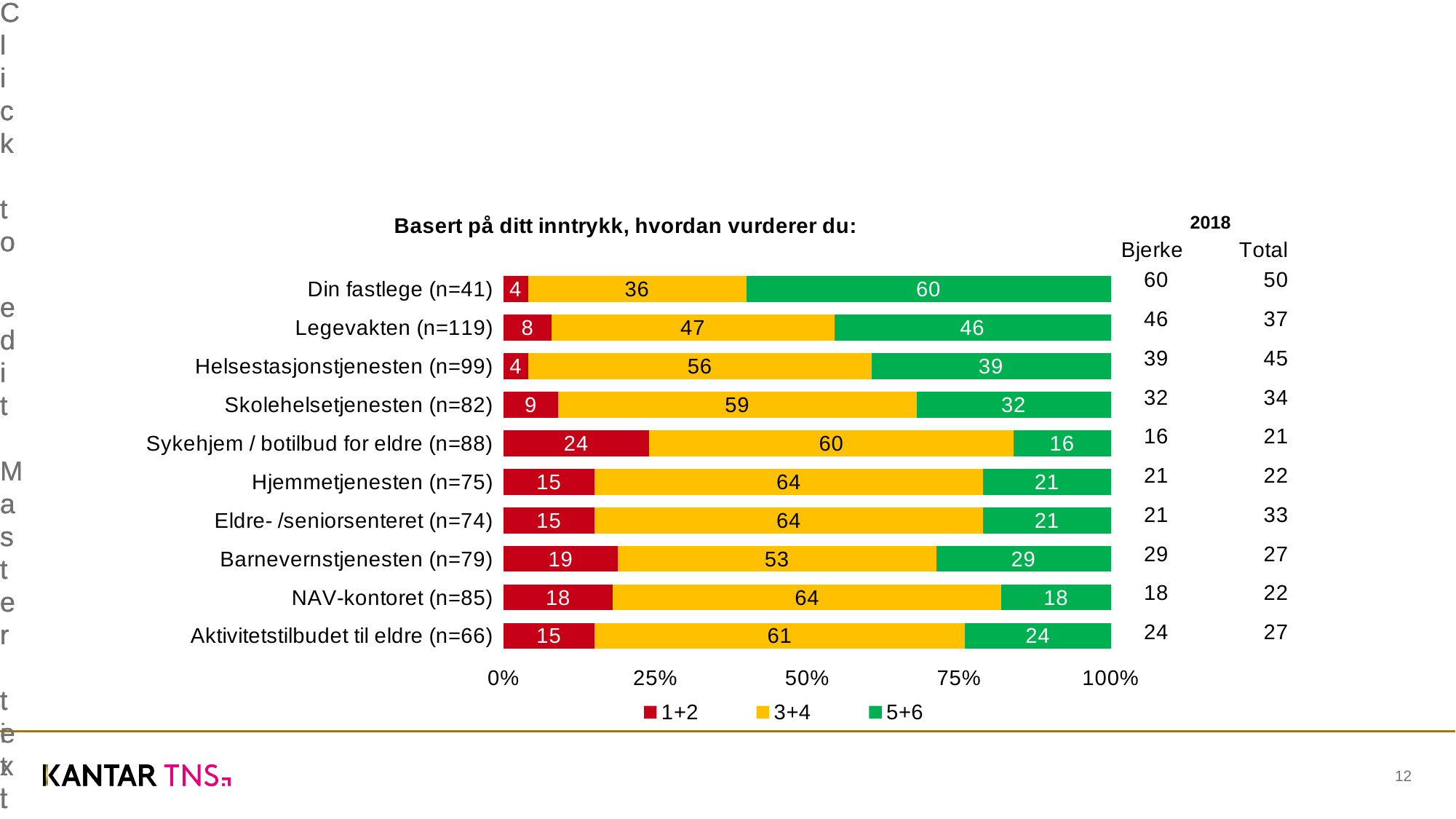
What is the total of the stacked bar for NAV-kontoret (n=85)? 100 Which category has the lowest 5+6 value? Sykehjem / botilbud for eldre (n=88) How many categories are shown in the chart? 10 What is the value of the 3+4 segment for Skolehelsetjenesten (n=82)? 59 What kind of chart is shown on the slide? Stacked bar chart What is the difference between the 5+6 value for Din fastlege (n=41) and the 5+6 value for Sykehjem / botilbud for eldre (n=88)? 44 Which has a larger 5+6 value, Legevakten (n=119) or Helsestasjonstjenesten (n=99)? Legevakten (n=119) What is the value of the 5+6 segment for Din fastlege (n=41)? 60 What is the value of the 1+2 segment for Sykehjem / botilbud for eldre (n=88)? 24 How many series does the legend list? 3 Which category has the highest 1+2 value? Sykehjem / botilbud for eldre (n=88) Which category has the highest 5+6 value? Din fastlege (n=41)